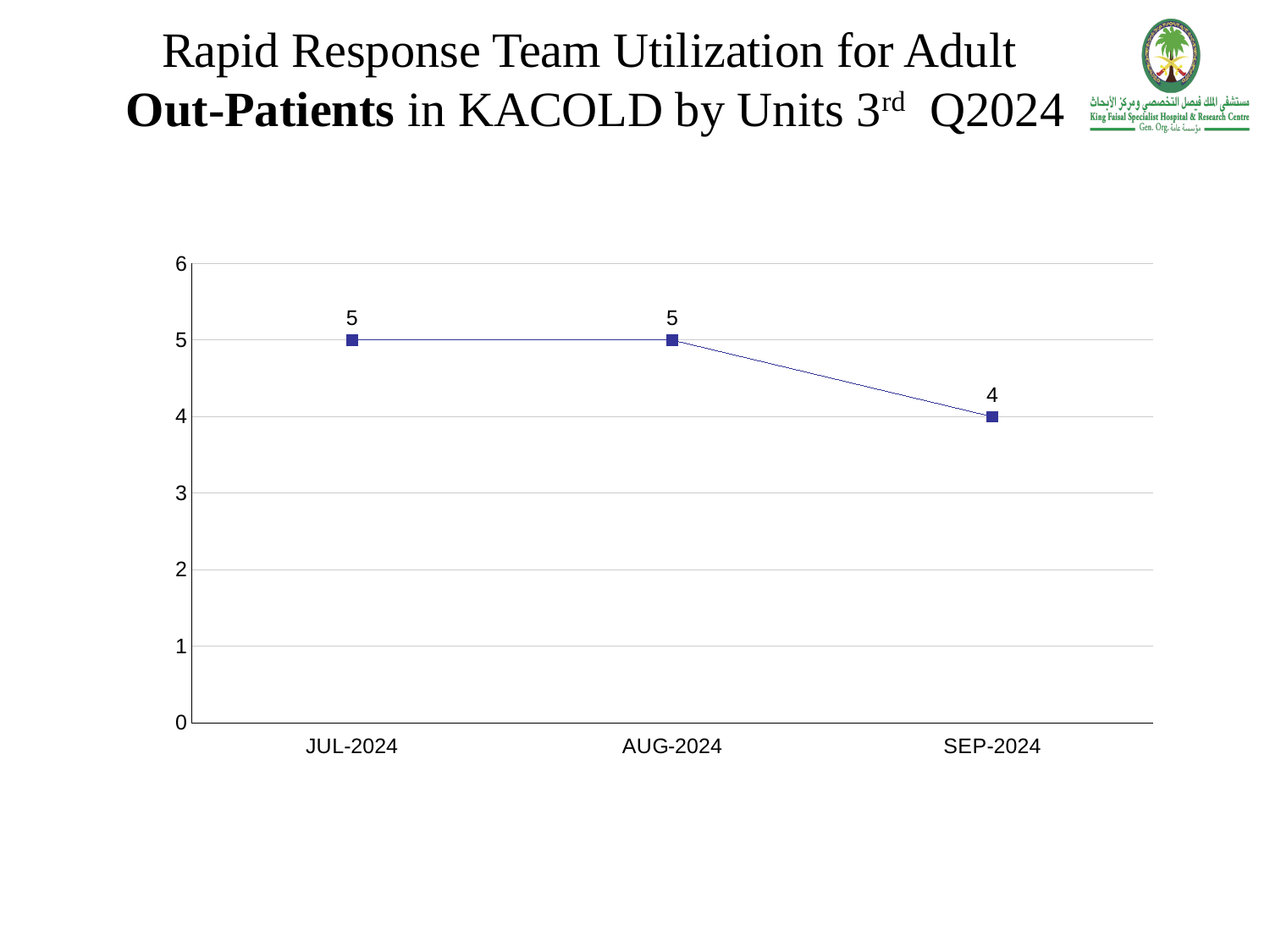
What is the total of the values for JUL-2024, AUG-2024 and SEP-2024? 14 What is the value for SEP-2024? 4 What is the value for AUG-2024? 5 How many months are plotted on the chart? 3 Do the values rise or fall from AUG-2024 to SEP-2024? fall What is the value for JUL-2024? 5 What is the highest value shown on the y axis? 6 What kind of chart is shown on the slide? line chart Which month has the lowest value? SEP-2024 What is the difference between the values for AUG-2024 and SEP-2024? 1 Is the value for SEP-2024 greater or less than 5? less Which is larger, the value for JUL-2024 or the value for SEP-2024? JUL-2024